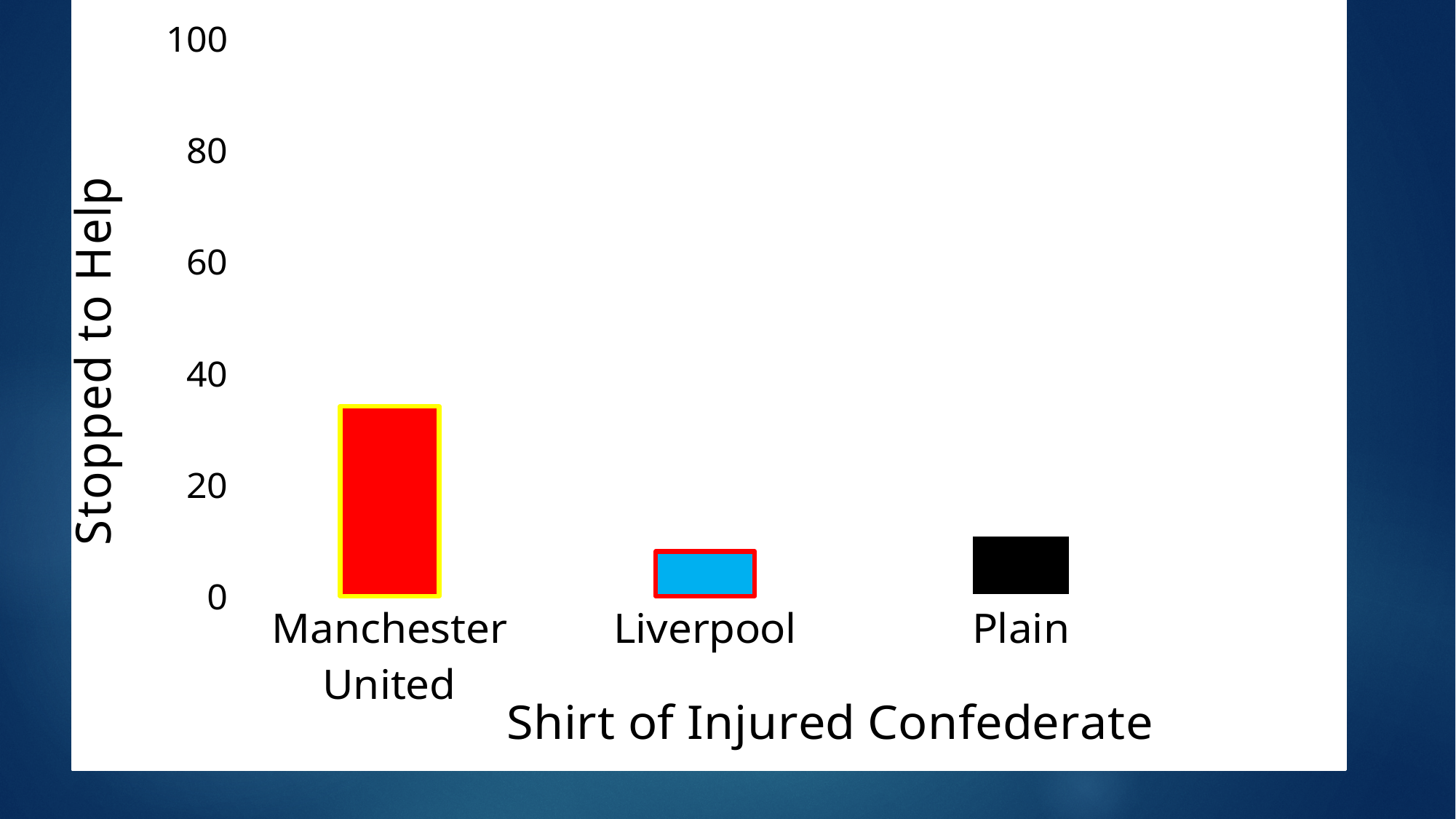
Which has a larger value, Manchester United or Liverpool? Manchester United How many shirt categories are shown on the x axis? 3 Which has a larger value, Manchester United or Plain? Manchester United What is the title of the vertical axis? Stopped to Help Is the value for Manchester United greater or less than 40? less What is the title of the horizontal axis? Shirt of Injured Confederate Is the value for Plain greater or less than 20? less Is the value for Manchester United greater or less than 20? greater What kind of chart is shown on the slide? bar chart Which shirt category has the highest value for Stopped to Help? Manchester United